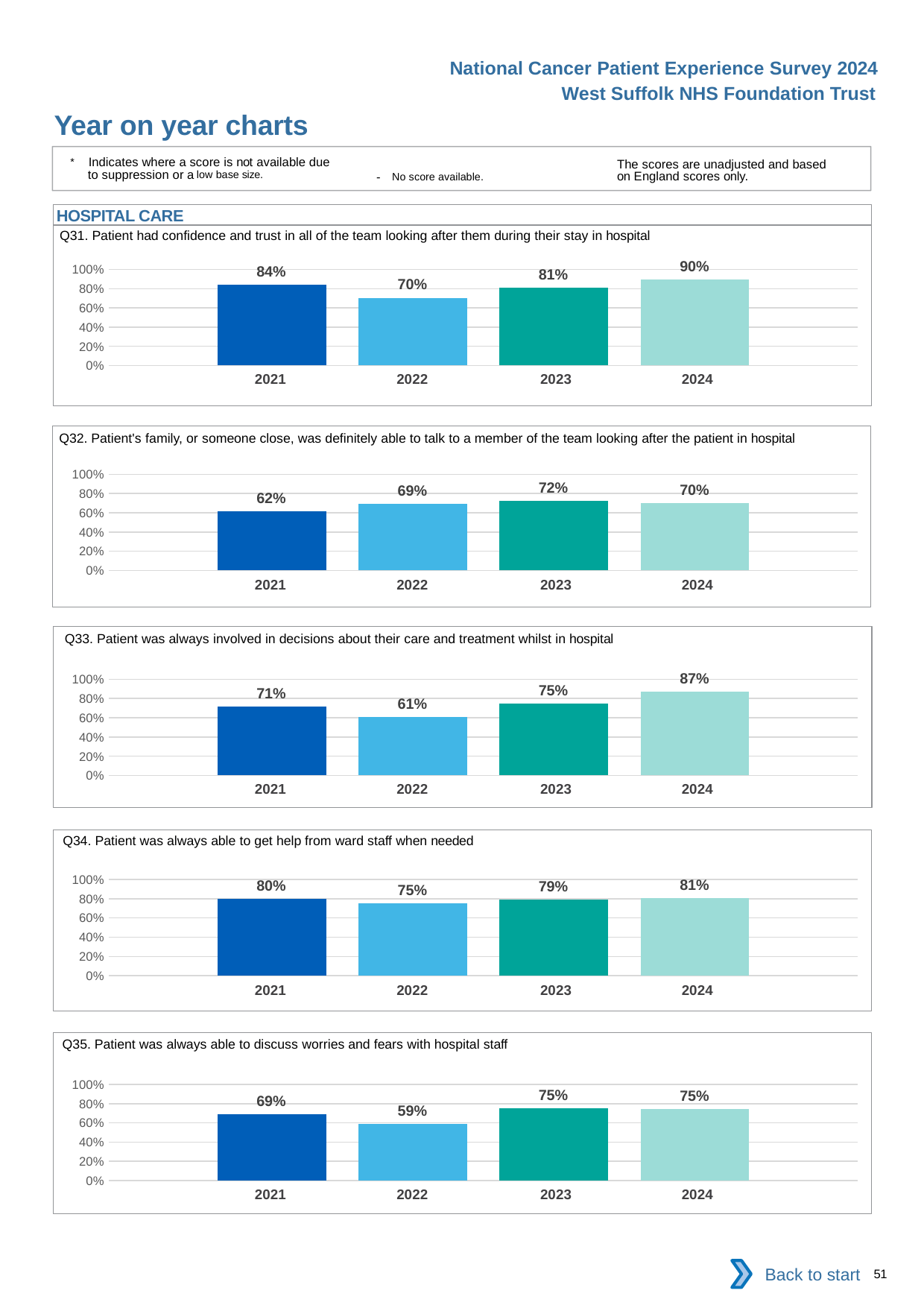
In the Q32 chart, what is the difference between the 2023 and 2021 values? 10% In the Q32 chart, which year has the highest value? 2023 In the Q34 chart, what is the difference between the 2024 and 2022 values? 6% In the Q35 chart, what is the value for 2021? 69% In the Q31 chart, what is the value for 2024? 90% What kind of chart is the Q33 chart? Bar chart In the Q33 chart, do the values rise or fall from 2022 to 2024? Rise In the Q34 chart, how many years are plotted? 4 In the Q31 chart, which year has the lowest value? 2022 In the Q35 chart, which year has the lowest value? 2022 In the Q33 chart, what is the value for 2022? 61% In the Q33 chart, is the value for 2024 larger than the value for 2021? Yes